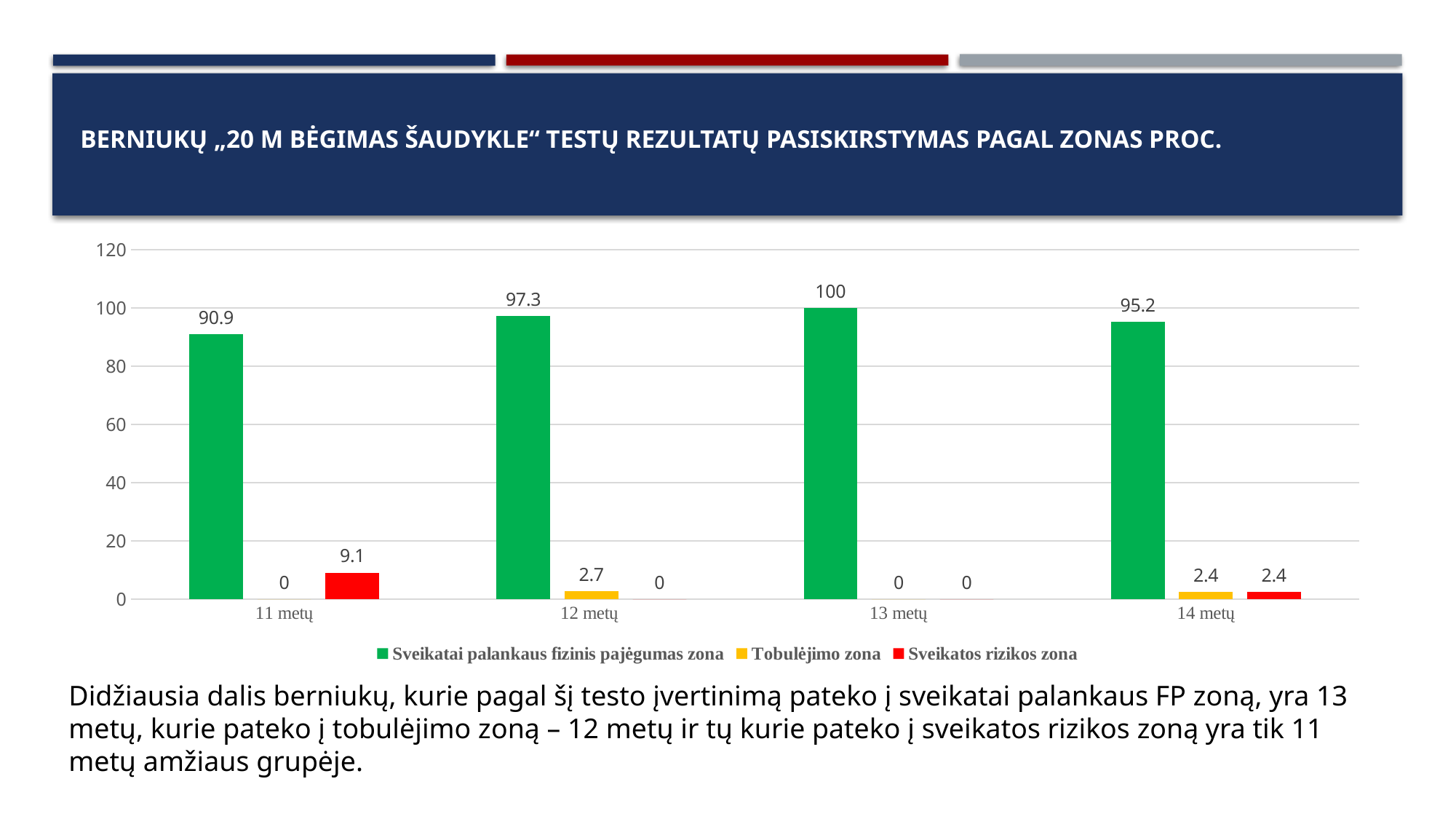
Which age group has the highest value for 'Sveikatai palankaus fizinis pajėgumas zona'? 13 metų What is the value for 'Sveikatos rizikos zona' for 11 metų? 9.1 Which age group has the lowest value for 'Sveikatai palankaus fizinis pajėgumas zona'? 11 metų What colour represents 'Tobulėjimo zona' in the chart? Yellow How many series does the legend list? 3 What is the value for 'Tobulėjimo zona' for 12 metų? 2.7 What is the value for 'Sveikatai palankaus fizinis pajėgumas zona' for 11 metų? 90.9 What is the value for 'Sveikatai palankaus fizinis pajėgumas zona' for 14 metų? 95.2 What kind of chart is shown on the slide? Bar chart What is the difference between the 'Sveikatai palankaus fizinis pajėgumas zona' values for 13 metų and 11 metų? 9.1 How many age groups are shown on the x axis? 4 Which is larger: the 'Sveikatos rizikos zona' value for 11 metų or for 14 metų? 11 metų